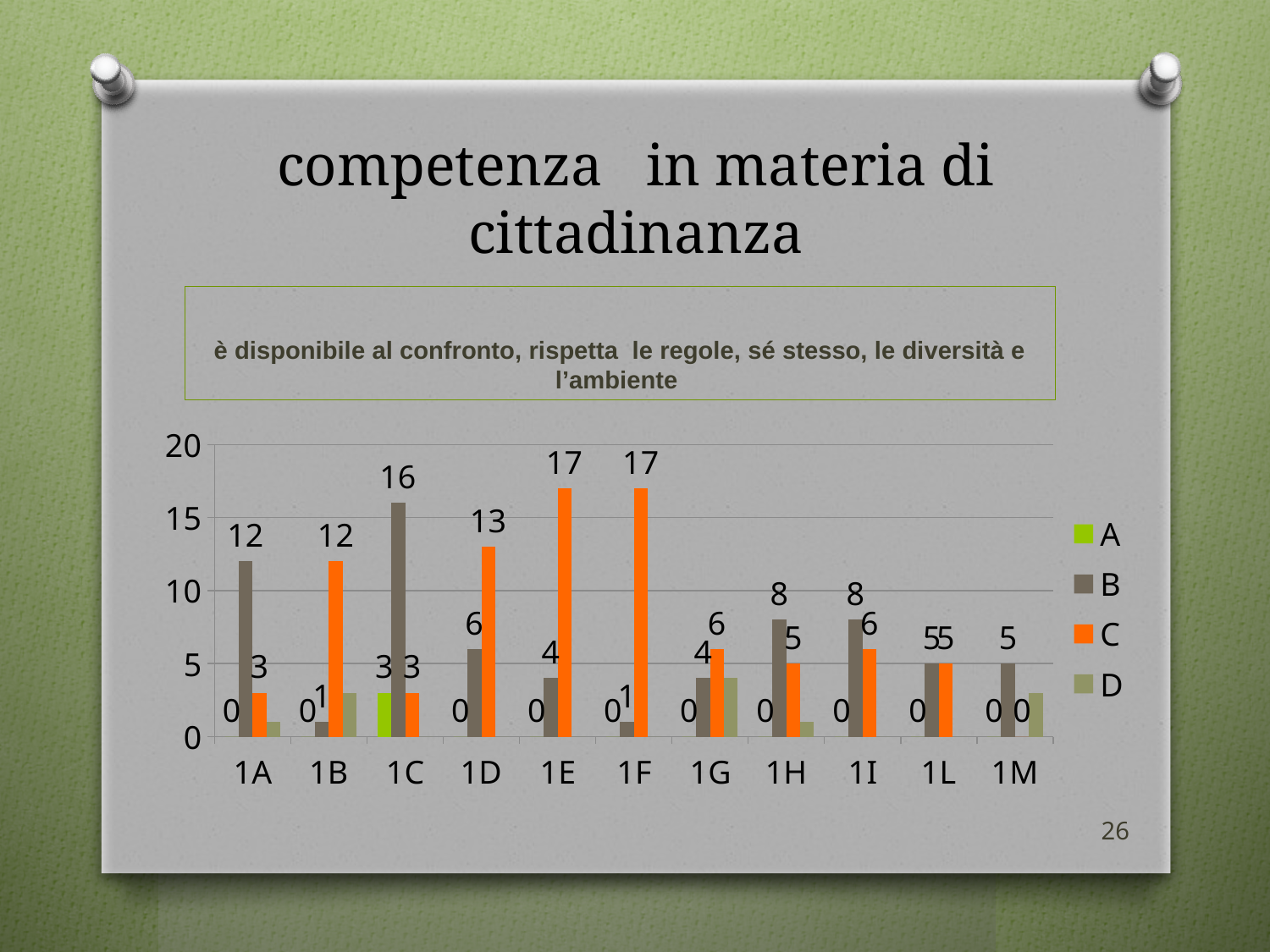
What type of chart is shown on the slide? bar chart For category 1D, which is larger: series B or series C? C What are the entries listed in the chart legend? A, B, C, D What is the value of series B for category 1C? 16 How many series does the legend list? 4 What is the value of series C for category 1E? 17 What is the value of series B for category 1H? 8 What is the difference between the series B values for 1C and 1A? 4 Is the value of series D for category 1B greater or less than 5? less Which category has the highest value for series B? 1C What is the value of series C for category 1D? 13 How many categories are shown on the x axis? 11